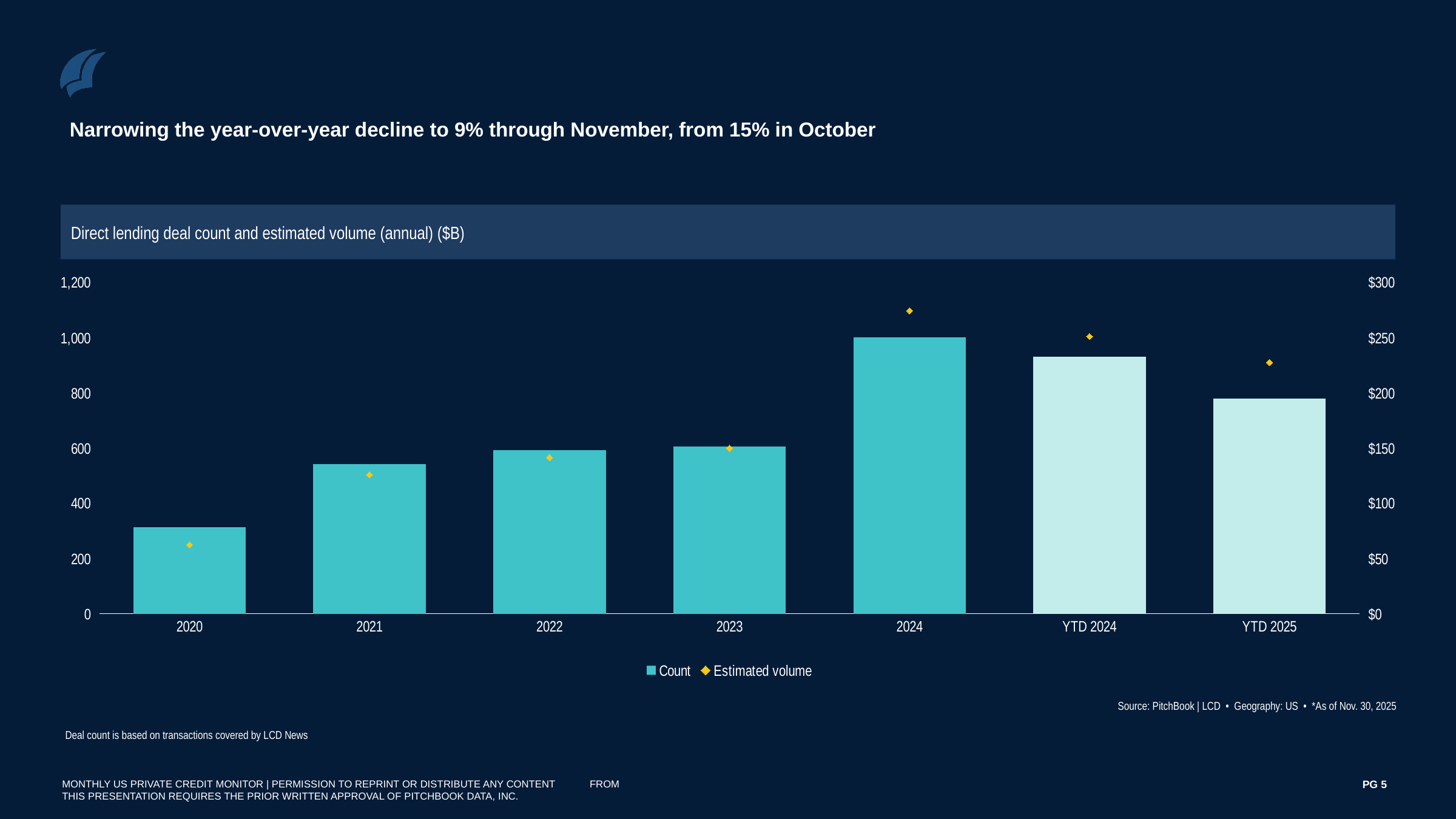
Is the Estimated volume for YTD 2025 greater or less than $250? less Which category has the lowest Count bar? 2020 Is the Count value for YTD 2024 greater or less than 1,000? less Is the Count value for 2024 greater or less than 800? greater Which category has the highest Count bar? 2024 Which has the larger Count, YTD 2024 or YTD 2025? YTD 2024 How many categories are shown on the x axis of the chart? 7 Do the Count bars rise or fall from 2020 to 2024? rise What kind of chart is shown on the slide? Bar chart with a line/marker series (combo chart) How many series does the chart's legend list? 2